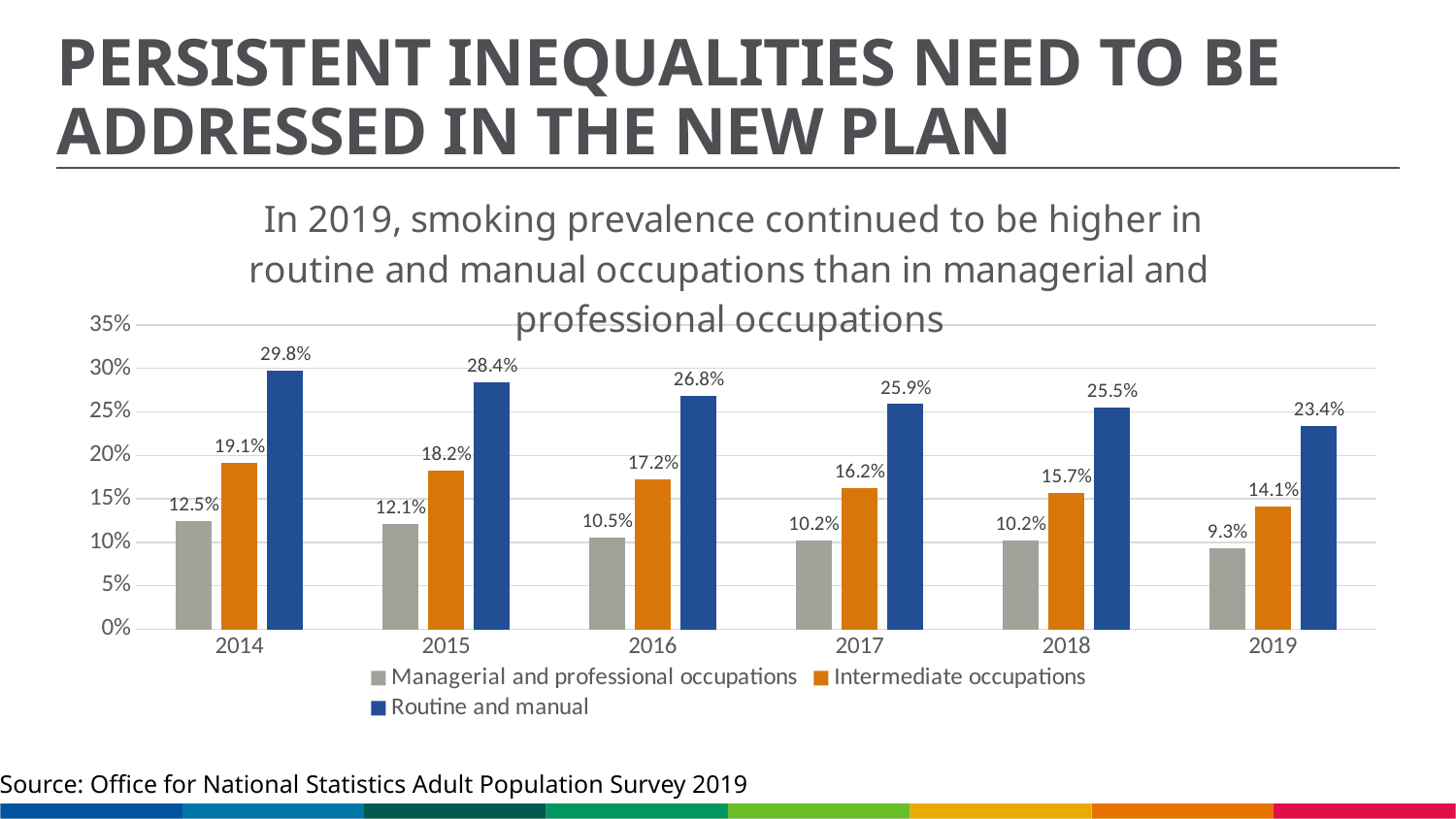
What was the smoking prevalence for Managerial and professional occupations in 2019? 9.3% In which year was smoking prevalence for Intermediate occupations lowest? 2019 What was the smoking prevalence for Intermediate occupations in 2017? 16.2% Which was higher in 2016: Intermediate occupations or Managerial and professional occupations? Intermediate occupations What is the difference between the Routine and manual value and the Managerial and professional value in 2019? 14.1% Does smoking prevalence for Routine and manual occupations rise or fall from 2014 to 2019? Fall What kind of chart is shown on the slide? Bar chart What was the smoking prevalence for Routine and manual occupations in 2014? 29.8% How many years are shown on the x axis? 6 How many series does the legend list? 3 Which colour represents Routine and manual occupations in the chart? Blue In which year was smoking prevalence for Routine and manual occupations highest? 2014